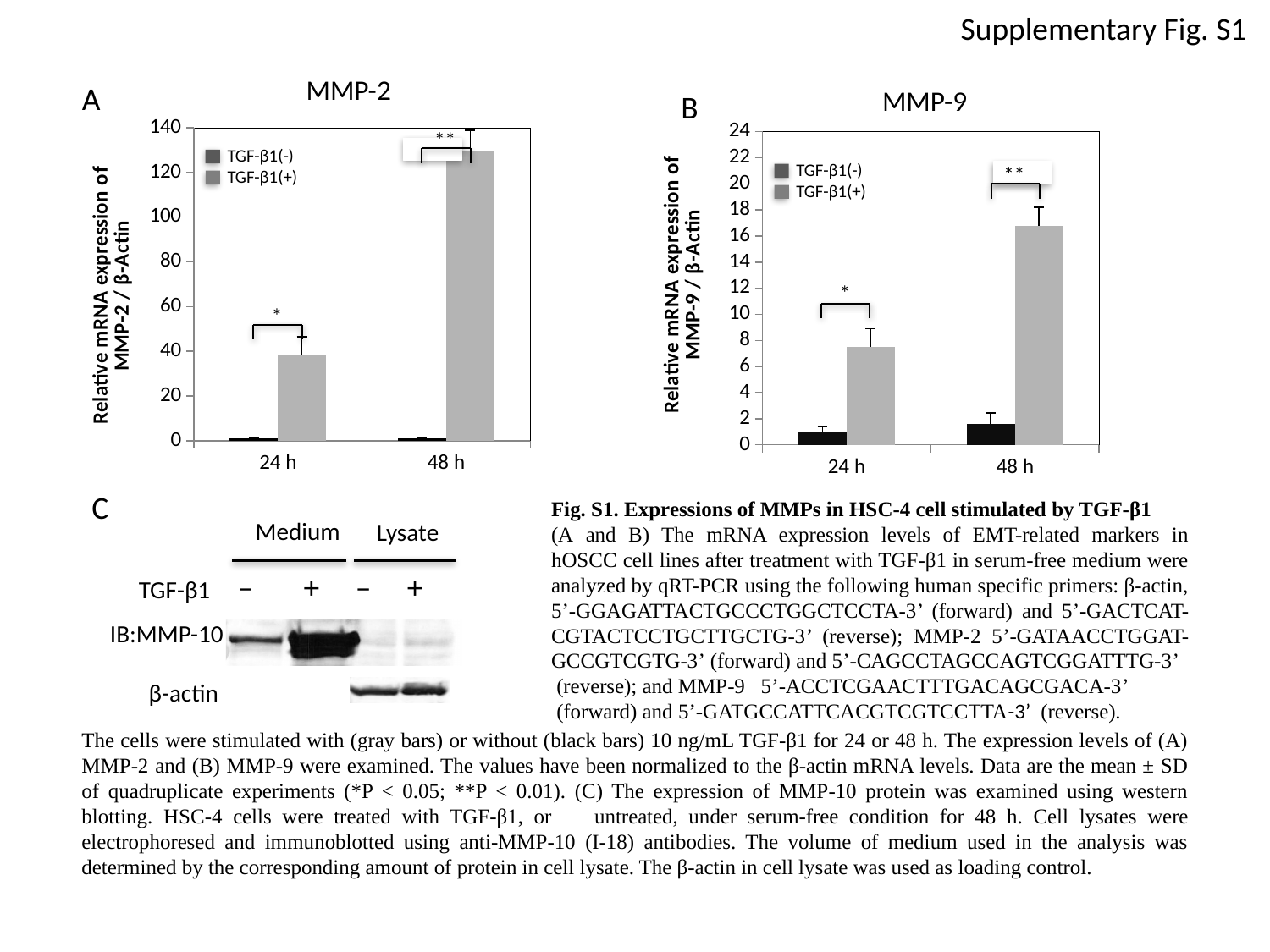
How many series does the legend of the MMP-9 chart list? 2 In the MMP-9 chart, is the value for TGF-β1(+) at 24 h greater or less than 10? less In the MMP-9 chart, does the TGF-β1(+) value rise or fall from 24 h to 48 h? rise What kind of chart is the MMP-2 chart? bar chart In the MMP-9 chart, is the value for TGF-β1(+) at 48 h greater or less than 14? greater How many time-point categories are shown on the x axis of the MMP-2 chart? 2 In the MMP-9 chart, which bar is the highest? TGF-β1(+) at 48 h In the MMP-2 chart, which is larger for TGF-β1(+): the value at 24 h or at 48 h? 48 h What is the y-axis title of the MMP-2 chart? Relative mRNA expression of MMP-2 / β-Actin In the MMP-2 chart, is the value for TGF-β1(+) at 24 h greater or less than 20? greater In the MMP-9 chart, which colour represents the TGF-β1(+) series? gray